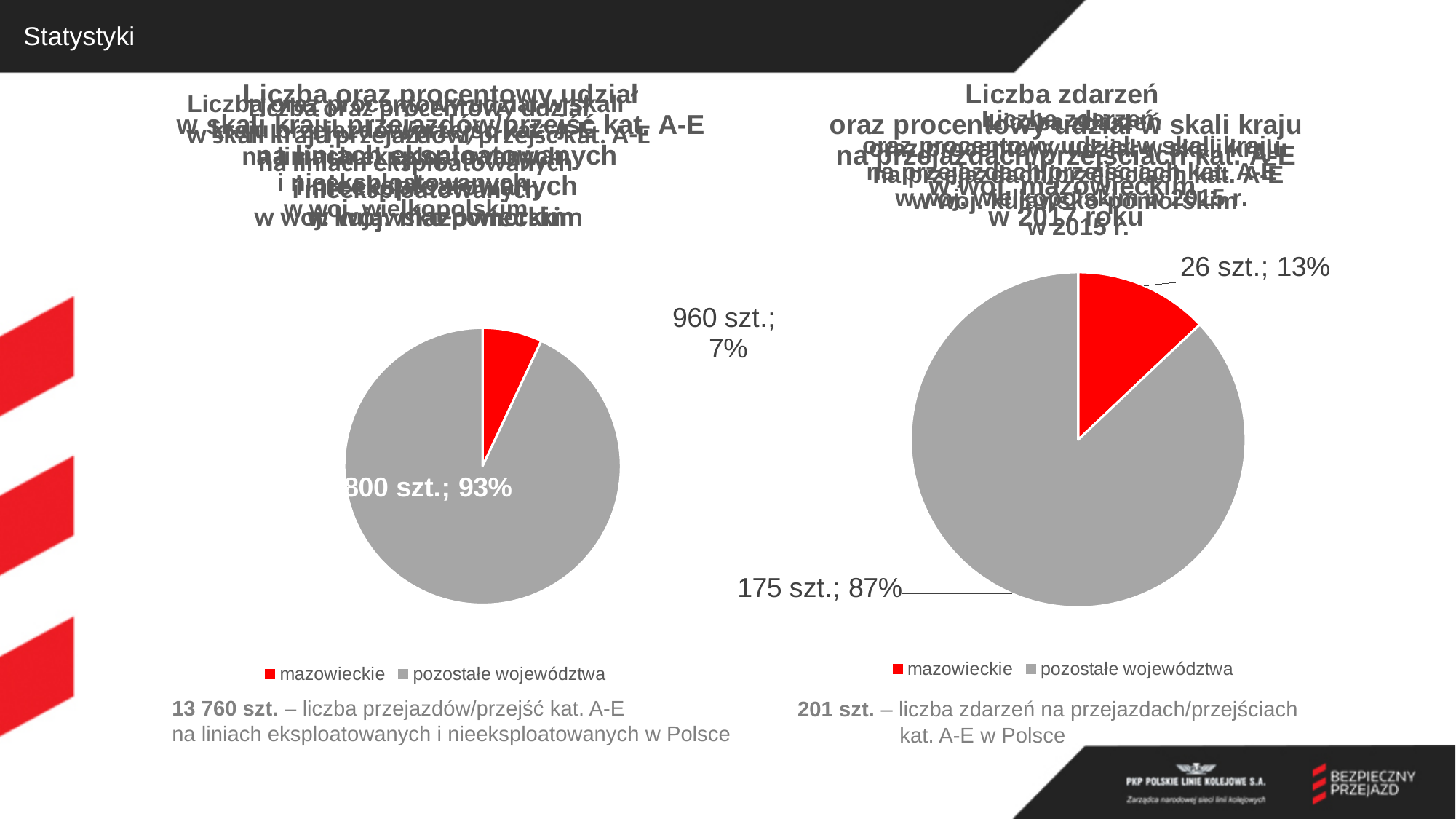
In the right pie chart, which category has the largest share? pozostałe województwa In the left pie chart, which slice is larger: mazowieckie or pozostałe województwa? pozostałe województwa In the legend of the right pie chart, what colour represents mazowieckie? red How many slices does the right pie chart have? 2 In the right pie chart, how many szt. are shown for pozostałe województwa? 175 szt. In the right pie chart, what percentage share does mazowieckie have? 13% In the right pie chart, what is the difference in szt. between pozostałe województwa and mazowieckie? 149 szt. In the right pie chart, how many szt. are shown for mazowieckie? 26 szt. In the left pie chart, what value is shown for mazowieckie? 960 szt.; 7% What type of chart is the left chart? pie chart In the left pie chart, what percentage share is shown for pozostałe województwa? 93% In the right pie chart, what is the total number of szt. across both slices? 201 szt.